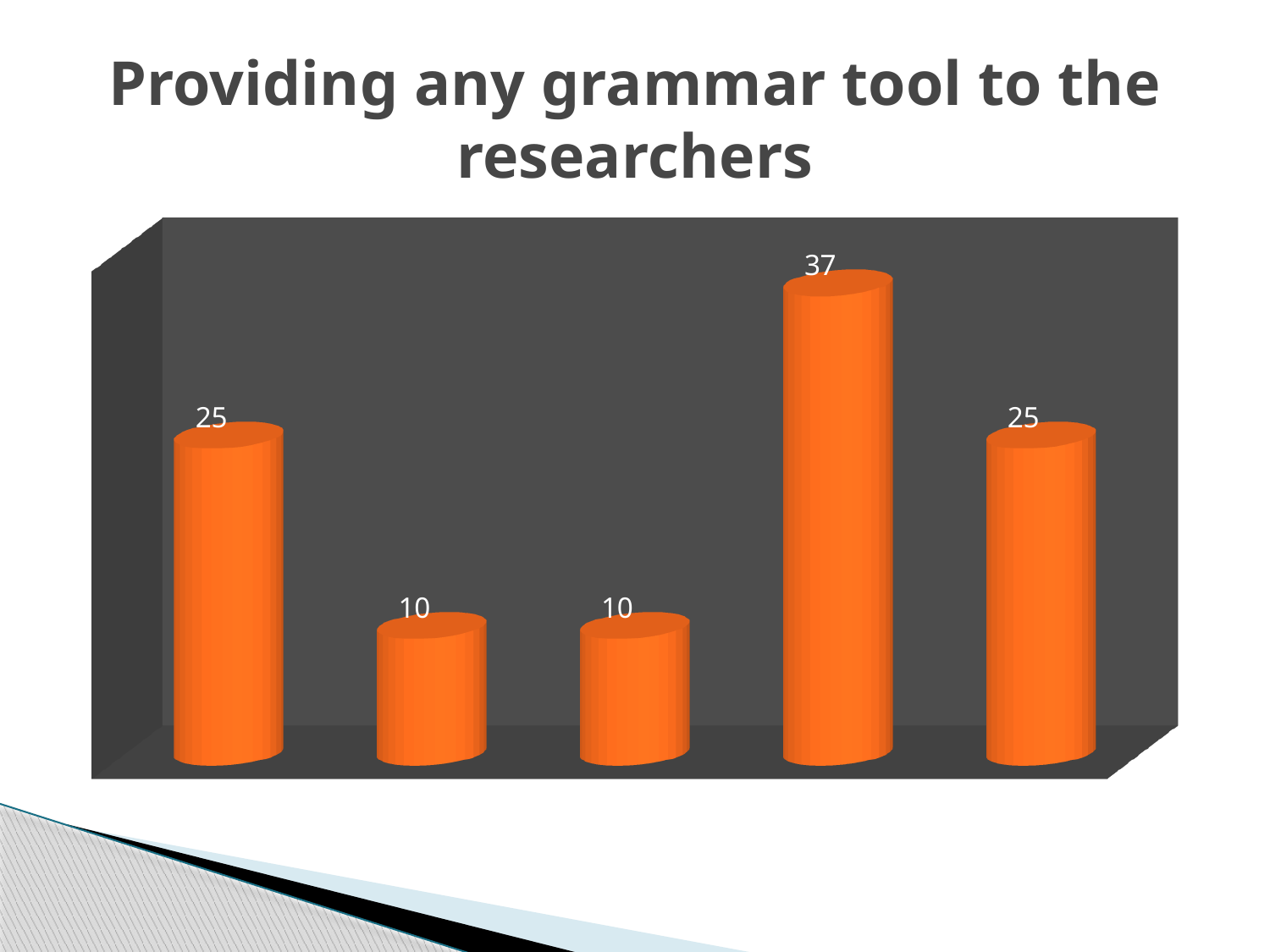
What is the value shown on the first (leftmost) bar? 25 How many bars are plotted in the chart? 5 What type of chart is shown on the slide? bar chart What colour are the bars in the chart? orange What is the lowest value shown in the chart? 10 What is the value shown on the second bar from the left? 10 What is the title of the chart? Providing any grammar tool to the researchers What is the difference between the highest bar (37) and the first bar (25)? 12 What is the highest value shown in the chart? 37 What is the value shown on the fourth bar from the left? 37 What is the value shown on the last (rightmost) bar? 25 Which is larger, the value of the fourth bar or the value of the fifth bar? the fourth bar